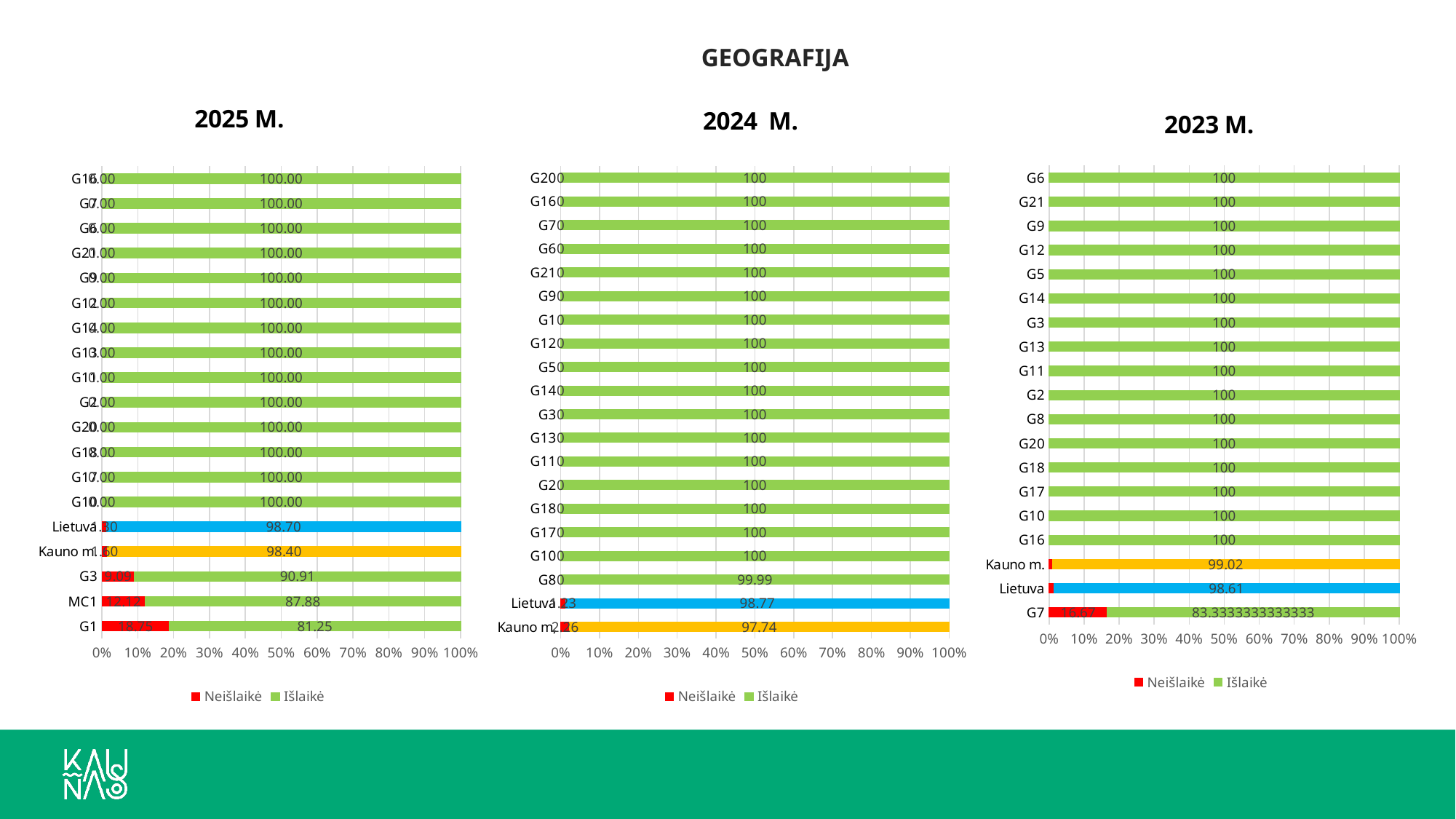
On the 2024 M. chart, what is the Išlaikė value for Kauno m.? 97.74 On the 2025 M. chart, what is the Išlaikė value for G1? 81.25 On the 2025 M. chart, what is the Išlaikė value for MC1? 87.88 On the 2024 M. chart, what is the Išlaikė value for G80? 99.99 On the 2025 M. chart, which category has the lowest Išlaikė value? G1 How many series does the legend of the 2023 M. chart list? 2 On the 2024 M. chart, which has the larger Išlaikė value, Lietuva or Kauno m.? Lietuva On the 2025 M. chart, what is the difference between the Išlaikė values for G3 and MC1? 3.03 On the 2025 M. chart, what is the Neišlaikė value for G1? 18.75 What kind of chart is the 2024 M. chart? Stacked bar chart On the 2023 M. chart, what is the Neišlaikė value for G7? 16.67 On the 2023 M. chart, what is the Išlaikė value for Kauno m.? 99.02